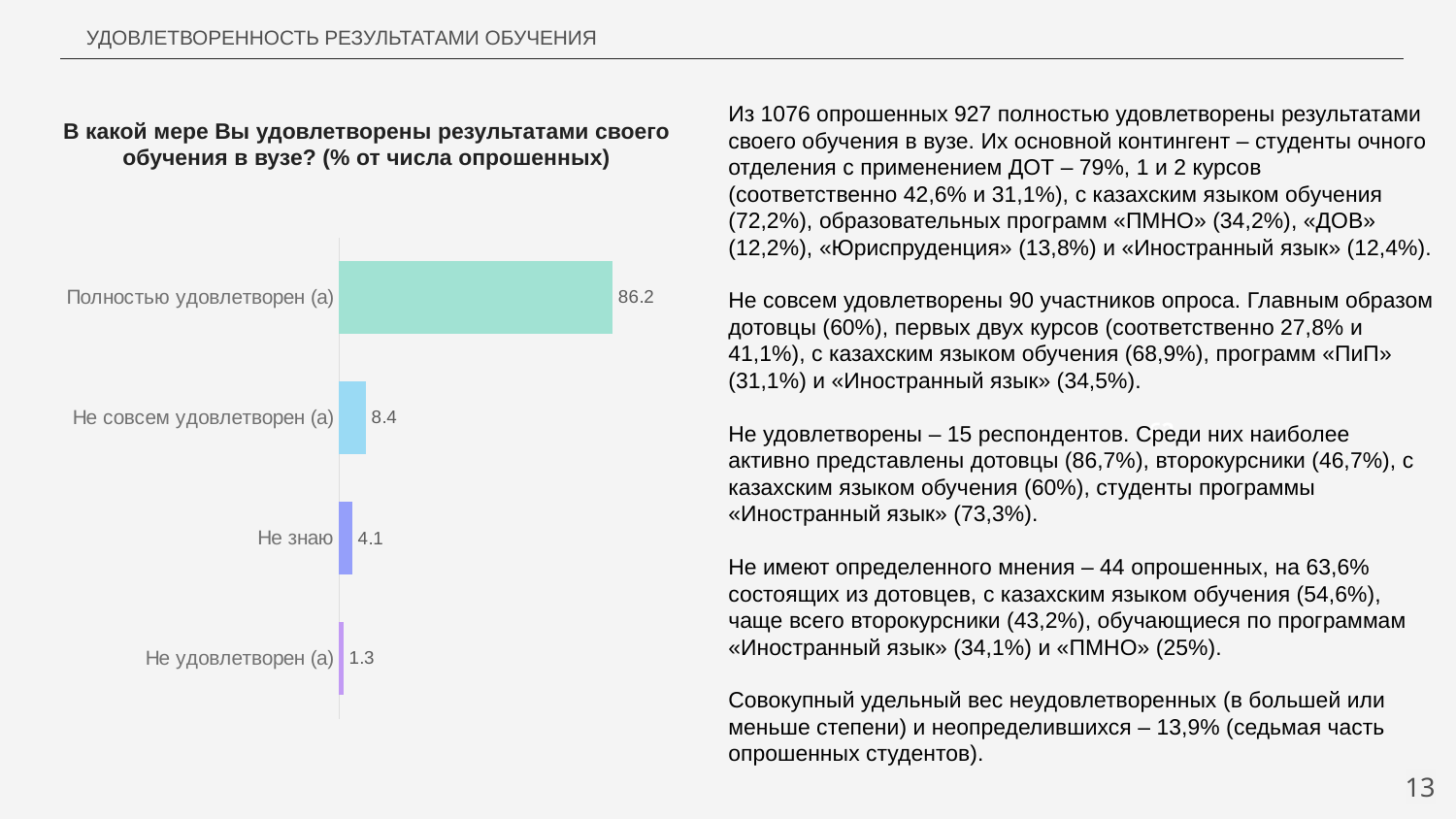
Which category has the lowest value? Не удовлетворен (а) What is the difference between the values for "Полностью удовлетворен (а)" and "Не совсем удовлетворен (а)"? 77.8 What is the value for "Не совсем удовлетворен (а)"? 8.4 How many categories are shown in the chart? 4 What is the value for "Полностью удовлетворен (а)"? 86.2 Which category has the highest value? Полностью удовлетворен (а) What is the difference between the values for "Не знаю" and "Не удовлетворен (а)"? 2.8 What is the title of the chart? В какой мере Вы удовлетворены результатами своего обучения в вузе? (% от числа опрошенных) What kind of chart is shown on the slide? Bar chart What is the value for "Не знаю"? 4.1 Which is larger: the value for "Не совсем удовлетворен (а)" or the value for "Не знаю"? Не совсем удовлетворен (а) What is the value for "Не удовлетворен (а)"? 1.3